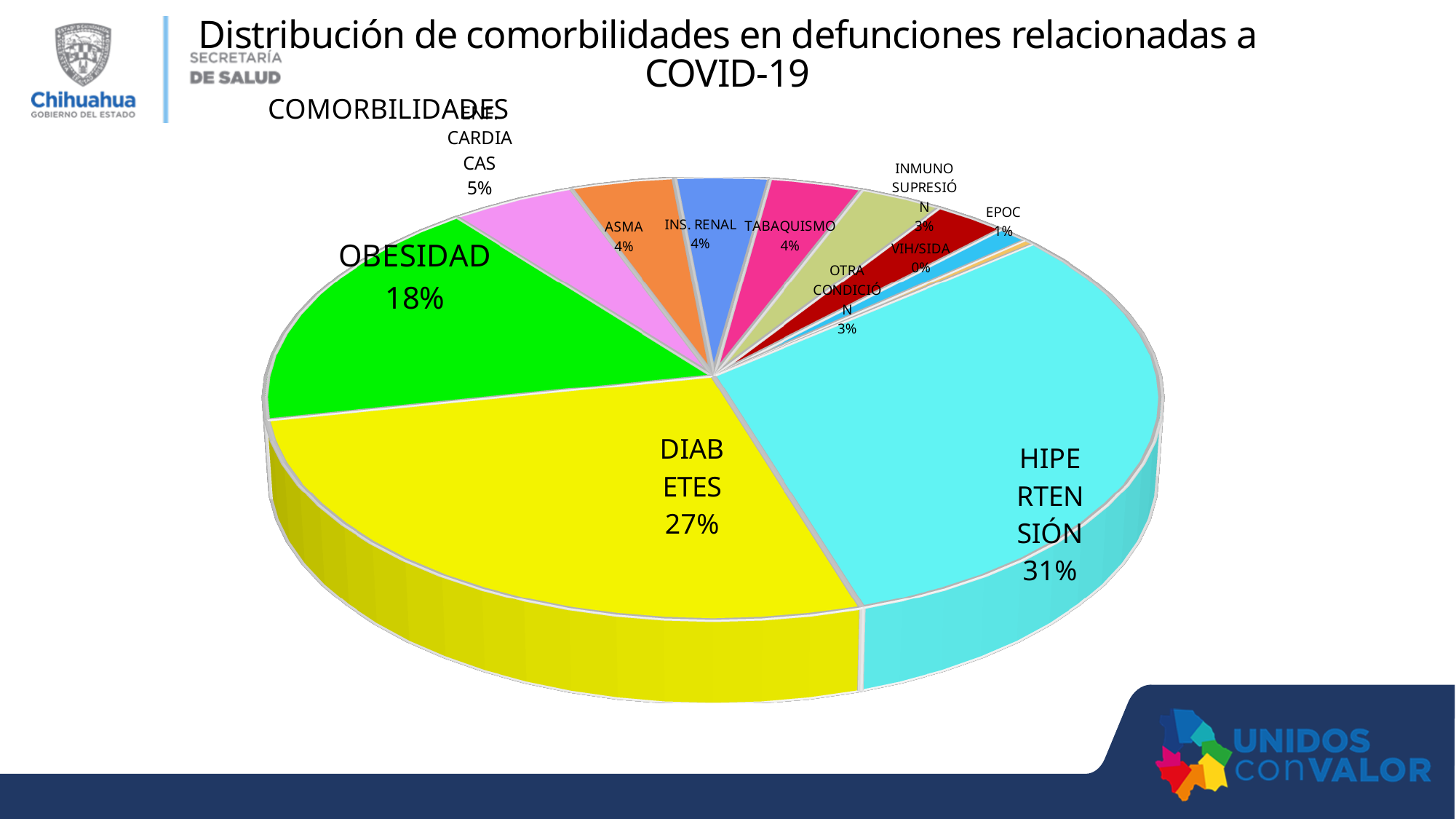
What kind of chart is shown on the slide? Pie chart What share of the pie does DIABETES represent? 27% Which comorbidity has the smallest slice of the pie? VIH/SIDA What percentage is shown for EPOC? 1% What share of the pie does HIPERTENSIÓN represent? 31% What is the title of the chart? COMORBILIDADES What percentage is shown for OBESIDAD? 18% Which is larger, the share for OBESIDAD or the share for ASMA? OBESIDAD What is the combined share of HIPERTENSIÓN, DIABETES and OBESIDAD? 76% Which comorbidity has the largest slice of the pie? HIPERTENSIÓN What percentage is shown for TABAQUISMO? 4% What is the difference in percentage points between HIPERTENSIÓN and DIABETES? 4